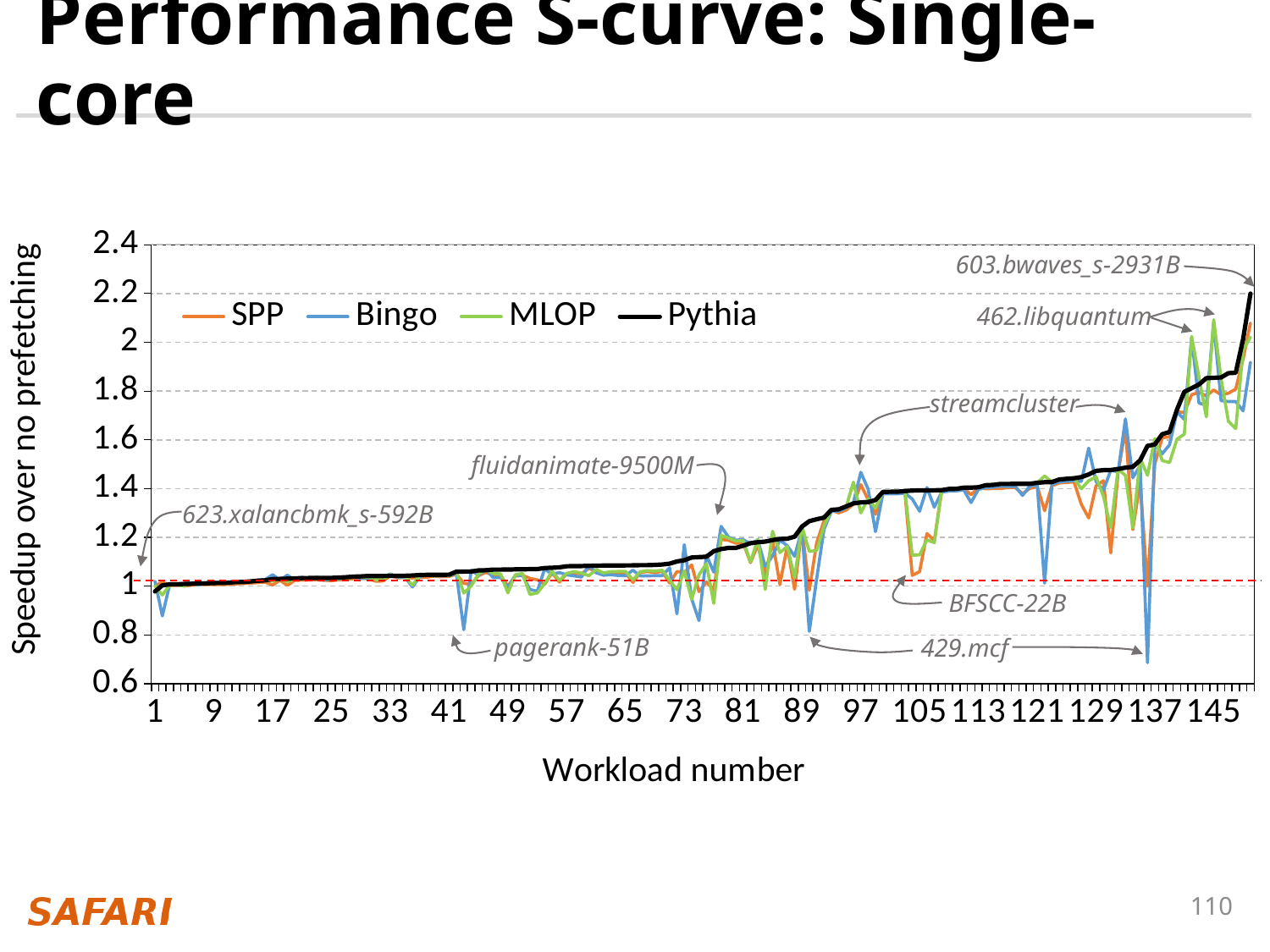
Is the Bingo value at the pagerank-51B dip greater or less than 1? less Which series are listed in the legend? SPP, Bingo, MLOP, Pythia What is the label of the y axis? Speedup over no prefetching How many series does the legend list? 4 Which series has the lowest point anywhere on the chart (at 429.mcf)? Bingo Is the Pythia value for the rightmost workload (603.bwaves_s-2931B) greater or less than 2? greater Is the Bingo value at the 429.mcf dip greater or less than 0.8? less Does the Pythia line rise or fall as the workload number increases along the x axis? rise Which series reaches the highest value at the rightmost workload (603.bwaves_s-2931B)? Pythia At the 429.mcf workload, which series has the larger value, Pythia or Bingo? Pythia What kind of chart is shown on the slide? line chart